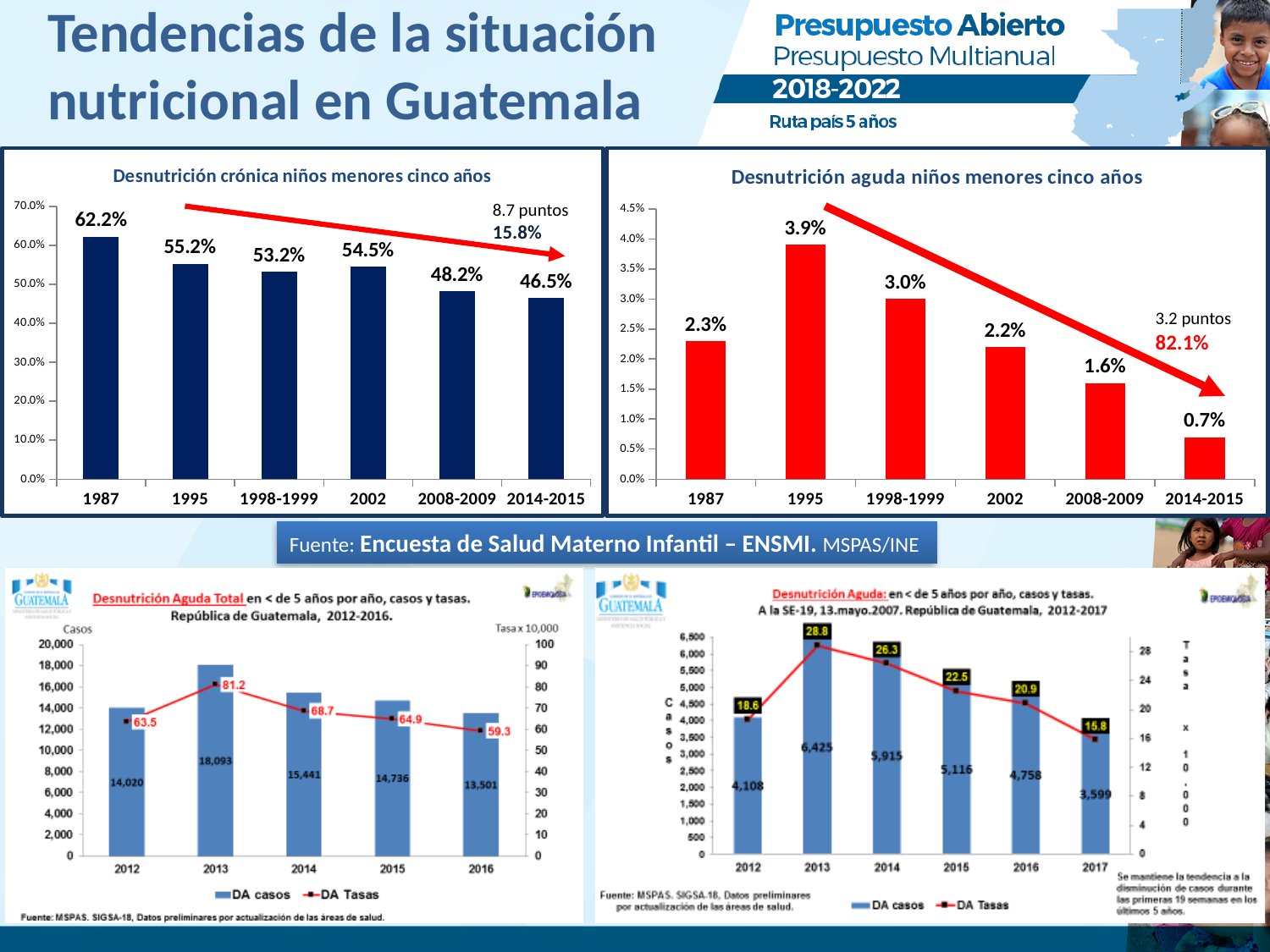
In the chart 'Desnutrición crónica niños menores cinco años', which period has the lowest value? 2014-2015 In the chart 'Desnutrición aguda niños menores cinco años', how many periods are shown on the x axis? 6 In the chart 'Desnutrición crónica niños menores cinco años', what is the difference between the values for 1987 and 2014-2015? 15.7 percentage points In the chart 'Desnutrición aguda niños menores cinco años', what is the value for 2008-2009? 1.6% In the bottom-right chart (Desnutrición Aguda, 2012-2017), which year has the highest DA Tasas value? 2013 In the bottom-left chart (Desnutrición Aguda Total, 2012-2016), what is the DA Tasas value for 2016? 59.3 In the bottom-right chart (Desnutrición Aguda, 2012-2017), how many DA casos were there in 2017? 3,599 In the bottom-left chart (Desnutrición Aguda Total, 2012-2016), how many series does the legend list? 2 In the chart 'Desnutrición crónica niños menores cinco años', what is the value for 1987? 62.2% In the bottom-left chart (Desnutrición Aguda Total, 2012-2016), how many DA casos were there in 2013? 18,093 In the chart 'Desnutrición aguda niños menores cinco años', which period has the highest value? 1995 In the chart 'Desnutrición aguda niños menores cinco años', is the value for 2002 larger or smaller than the value for 1998-1999? smaller